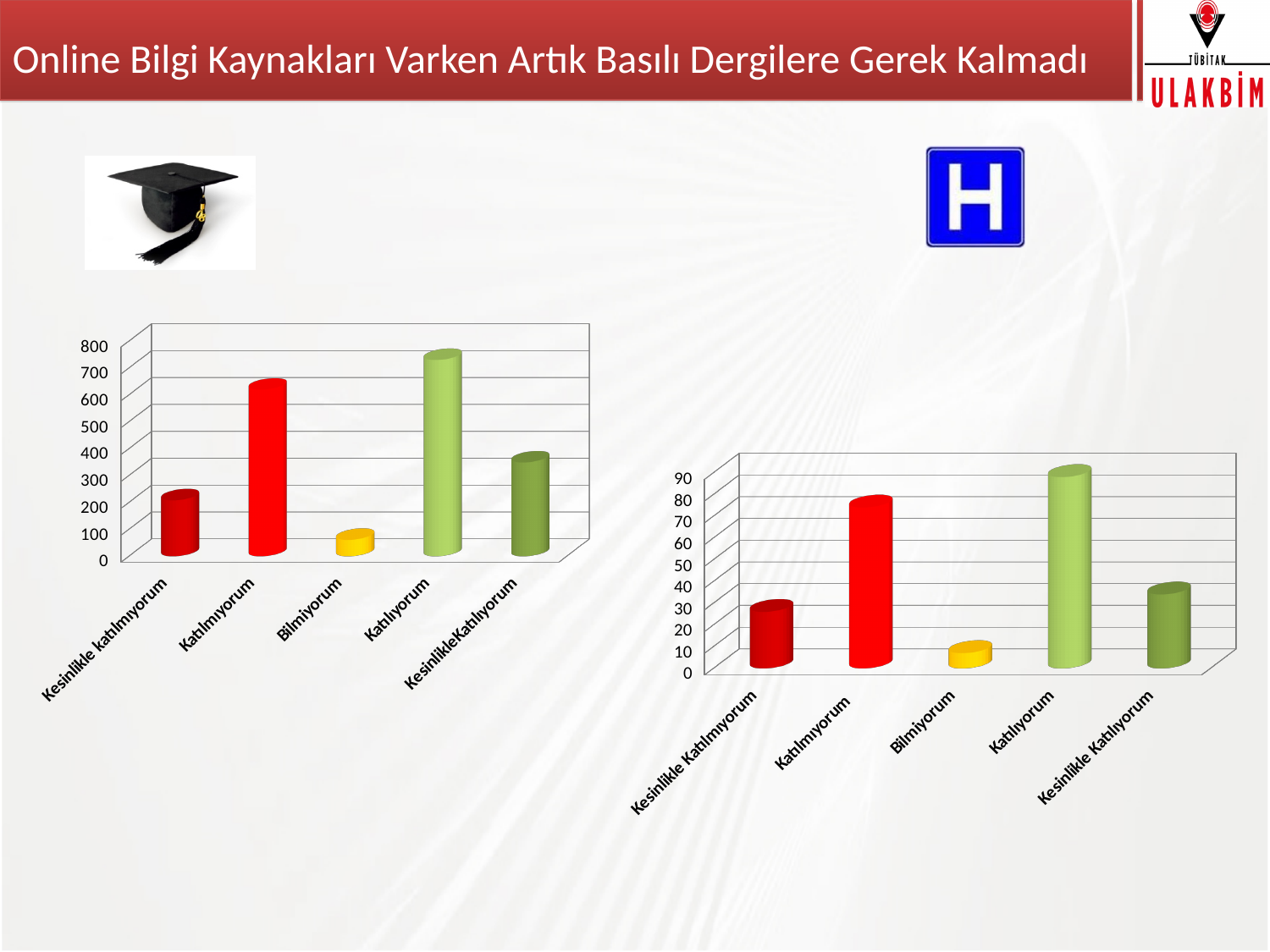
In the left chart, is the value for Katılmıyorum greater or less than 500? greater In the right chart, which category has the highest bar? Katılıyorum In the right chart, which is larger, the value for Kesinlikle Katılmıyorum or the value for Katılıyorum? Katılıyorum In the right chart, is the value for Katılmıyorum greater or less than 60? greater What type of chart is the left chart on the slide? bar chart What colour is the Bilmiyorum bar in the left chart? yellow In the left chart, which category has the lowest bar? Bilmiyorum In the left chart, which category has the highest bar? Katılıyorum In the left chart, is the value for Kesinlikle katılmıyorum greater or less than 300? less How many categories does the right chart show? 5 How many categories does the left chart show? 5 In the right chart, which category has the lowest bar? Bilmiyorum